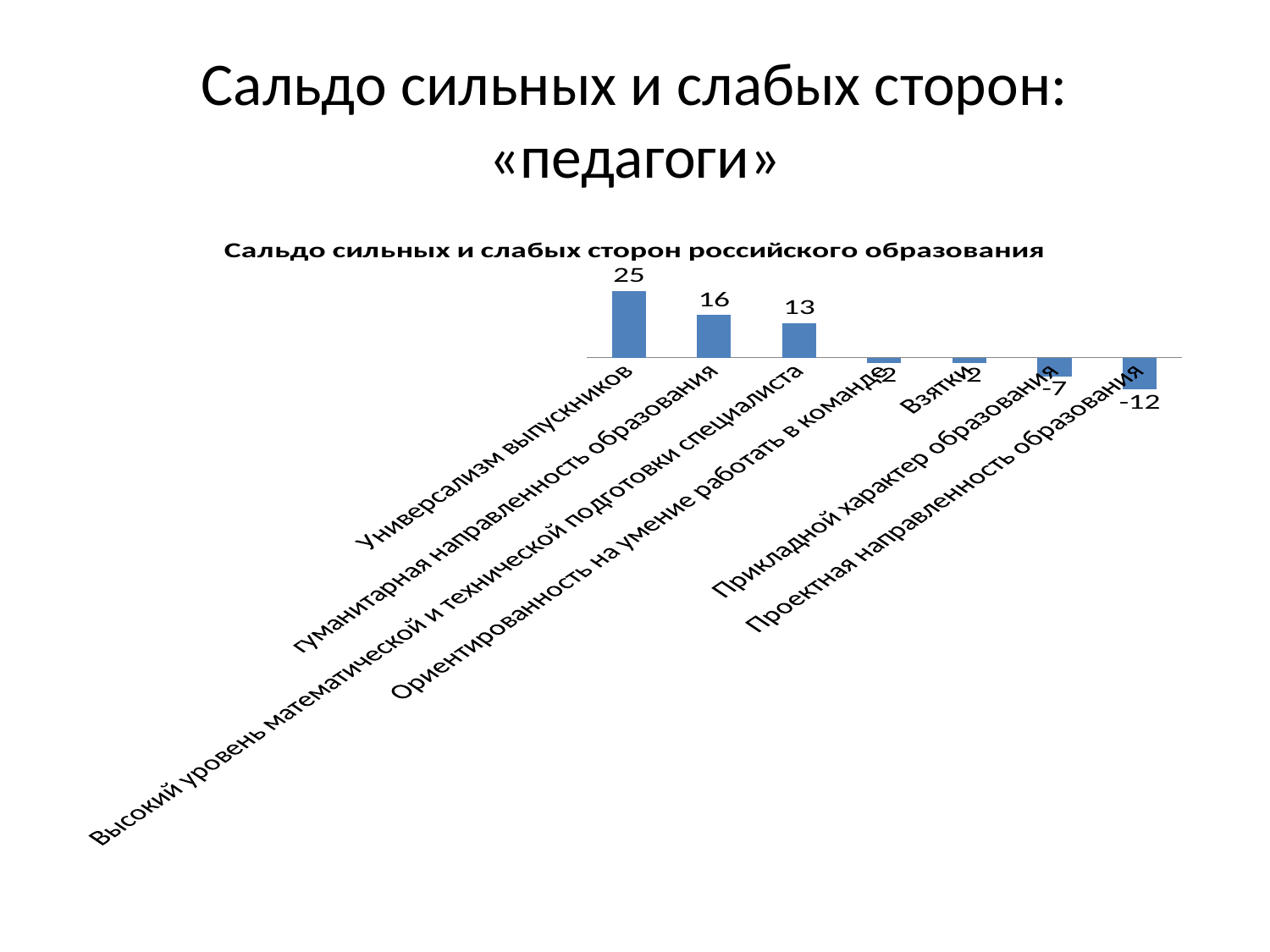
What is the title of the chart? Сальдо сильных и слабых сторон российского образования Which is larger, the value for Гуманитарная направленность образования or the value for Высокий уровень математической и технической подготовки специалиста? Гуманитарная направленность образования Which category has the lowest value? Проектная направленность образования What is the difference between the values for Универсализм выпускников and Гуманитарная направленность образования? 9 What is the value for Высокий уровень математической и технической подготовки специалиста? 13 What is the value for Универсализм выпускников? 25 What is the value for Прикладной характер образования? -7 What is the value for Проектная направленность образования? -12 How many categories are plotted in the chart? 7 What is the value for Гуманитарная направленность образования? 16 Which category has the highest value? Универсализм выпускников What type of chart is shown on the slide? bar chart